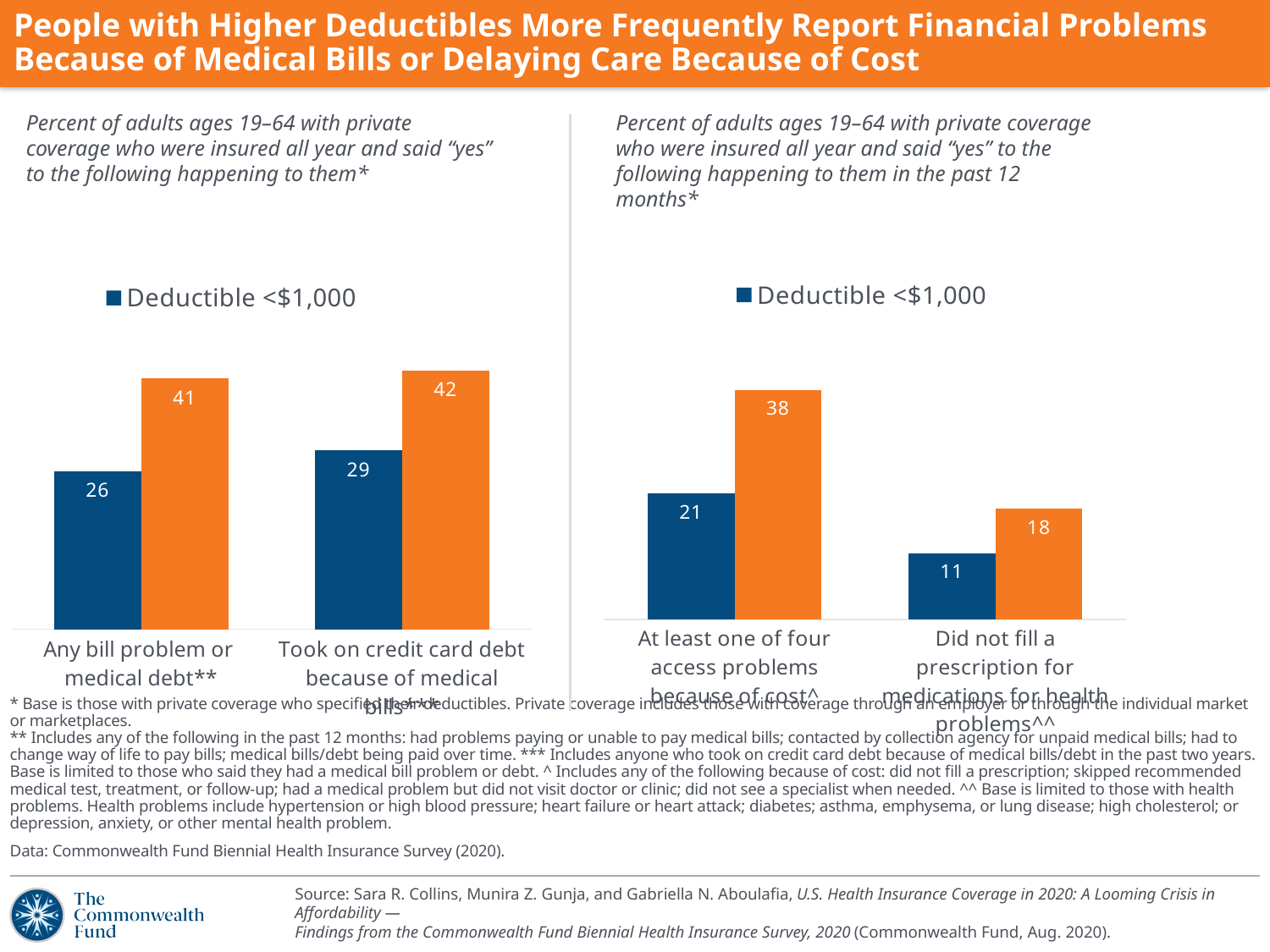
In the left chart, what is the value for Deductible <$1,000 for 'Any bill problem or medical debt'? 26 In the right chart, what is the value of the orange bar for 'Did not fill a prescription for medications for health problems'? 18 In the left chart, what is the difference between the orange bar and the Deductible <$1,000 bar for 'Any bill problem or medical debt'? 15 In the right chart, what is the difference between the two bars for 'Did not fill a prescription for medications for health problems'? 7 How many categories are shown on the x axis of the right chart? 2 What type of chart is the left chart? Bar chart In the left chart, which is larger for Deductible <$1,000: 'Any bill problem or medical debt' or 'Took on credit card debt because of medical bills'? Took on credit card debt because of medical bills In the right chart, which bar has the lowest value? Deductible <$1,000 for 'Did not fill a prescription for medications for health problems' (11) In the left chart, what is the value of the orange bar for 'Took on credit card debt because of medical bills'? 42 In the left chart, which bar has the highest value? The orange bar for 'Took on credit card debt because of medical bills' (42) In the right chart, what is the difference between the orange bar and the Deductible <$1,000 bar for 'At least one of four access problems because of cost'? 17 In the right chart, what is the value for Deductible <$1,000 for 'At least one of four access problems because of cost'? 21